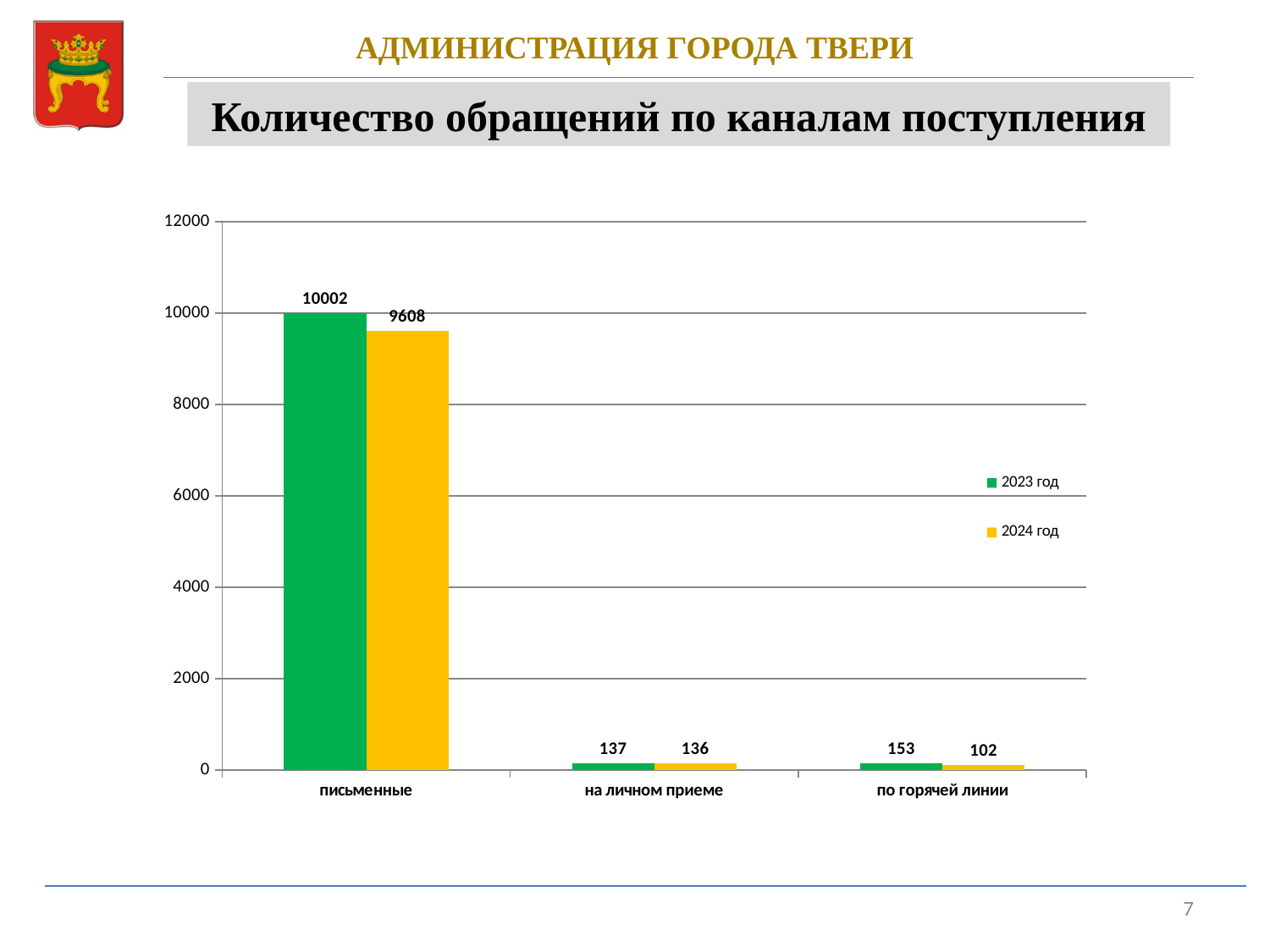
Which category has the lowest value in 2023 год? на личном приеме What is the difference between the 2023 год and 2024 год values for письменные? 394 What is the value for на личном приеме in 2023 год? 137 What is the value for письменные in 2024 год? 9608 How many series does the legend list? 2 What is the difference between the 2023 год and 2024 год values for по горячей линии? 51 How many categories are shown on the x axis? 3 Which is larger for по горячей линии: the 2023 год value or the 2024 год value? 2023 год What kind of chart is shown on the slide? bar chart What is the value for письменные in 2023 год? 10002 What is the value for по горячей линии in 2024 год? 102 Which category has the highest value in 2024 год? письменные